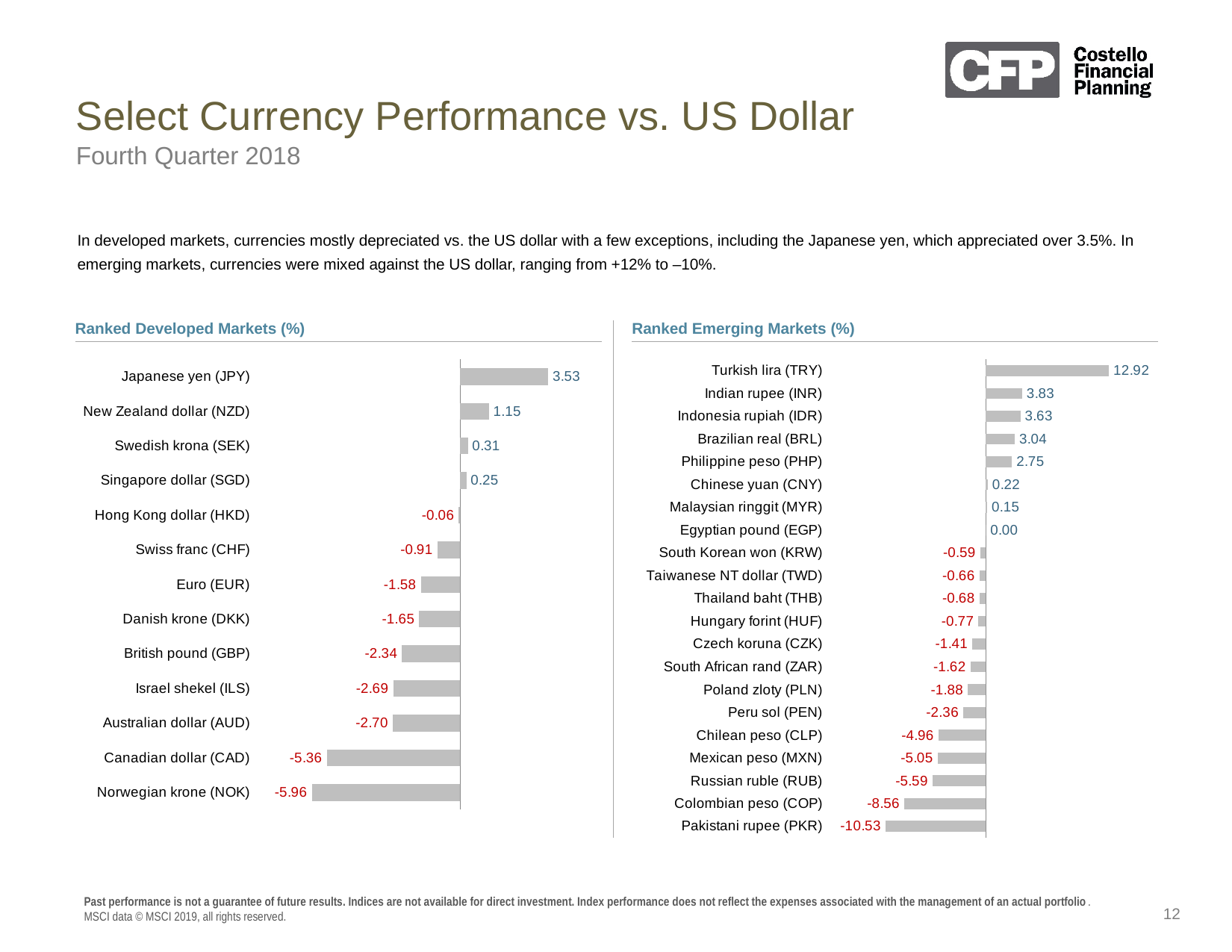
In the Ranked Emerging Markets (%) chart, which currency has the lowest value? Pakistani rupee (PKR) In the Ranked Emerging Markets (%) chart, what is the difference between the Indian rupee (INR) and the Indonesia rupiah (IDR)? 0.20 In the Ranked Emerging Markets (%) chart, do the values rise or fall going down the list from Turkish lira (TRY) to Pakistani rupee (PKR)? Fall What type of chart is the Ranked Emerging Markets (%) chart? Bar chart In the Ranked Developed Markets (%) chart, what is the difference between the Canadian dollar (CAD) and the Norwegian krone (NOK)? 0.60 In the Ranked Developed Markets (%) chart, how many currencies are shown? 13 In the Ranked Emerging Markets (%) chart, what is the value for the Egyptian pound (EGP)? 0.00 In the Ranked Emerging Markets (%) chart, how many currencies are shown? 21 In the Ranked Developed Markets (%) chart, which is larger, the value for the Euro (EUR) or the British pound (GBP)? Euro (EUR) In the Ranked Emerging Markets (%) chart, what is the value for the Turkish lira (TRY)? 12.92 In the Ranked Developed Markets (%) chart, which currency has the lowest value? Norwegian krone (NOK) In the Ranked Developed Markets (%) chart, what is the value for the Japanese yen (JPY)? 3.53